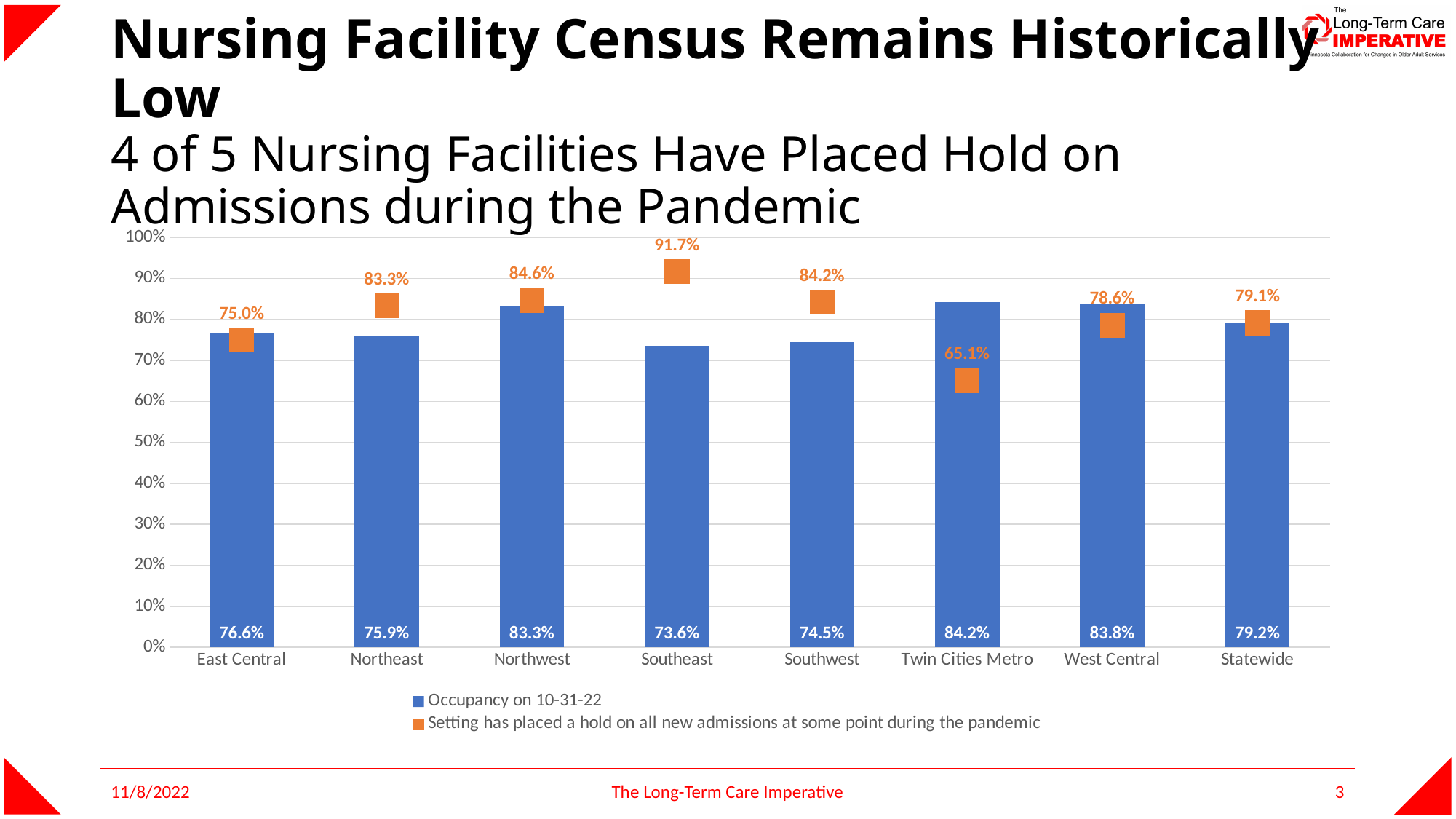
How many regions (categories) are shown on the x axis? 8 In Southeast, what is the difference between the share of settings that placed a hold on admissions and the occupancy on 10-31-22? 18.1 percentage points Which region has the lowest occupancy on 10-31-22? Southeast How many series does the legend list? 2 Which region has the highest share of settings that placed a hold on all new admissions during the pandemic? Southeast What colour are the markers for the series 'Setting has placed a hold on all new admissions at some point during the pandemic'? Orange What percentage of settings in Southeast have placed a hold on all new admissions at some point during the pandemic? 91.7% What is the Statewide occupancy on 10-31-22? 79.2% Is the occupancy on 10-31-22 higher in Northeast or in West Central? West Central What is the occupancy on 10-31-22 for Northwest? 83.3% Which region has the highest occupancy on 10-31-22? Twin Cities Metro Which region has the lowest share of settings that placed a hold on all new admissions during the pandemic? Twin Cities Metro